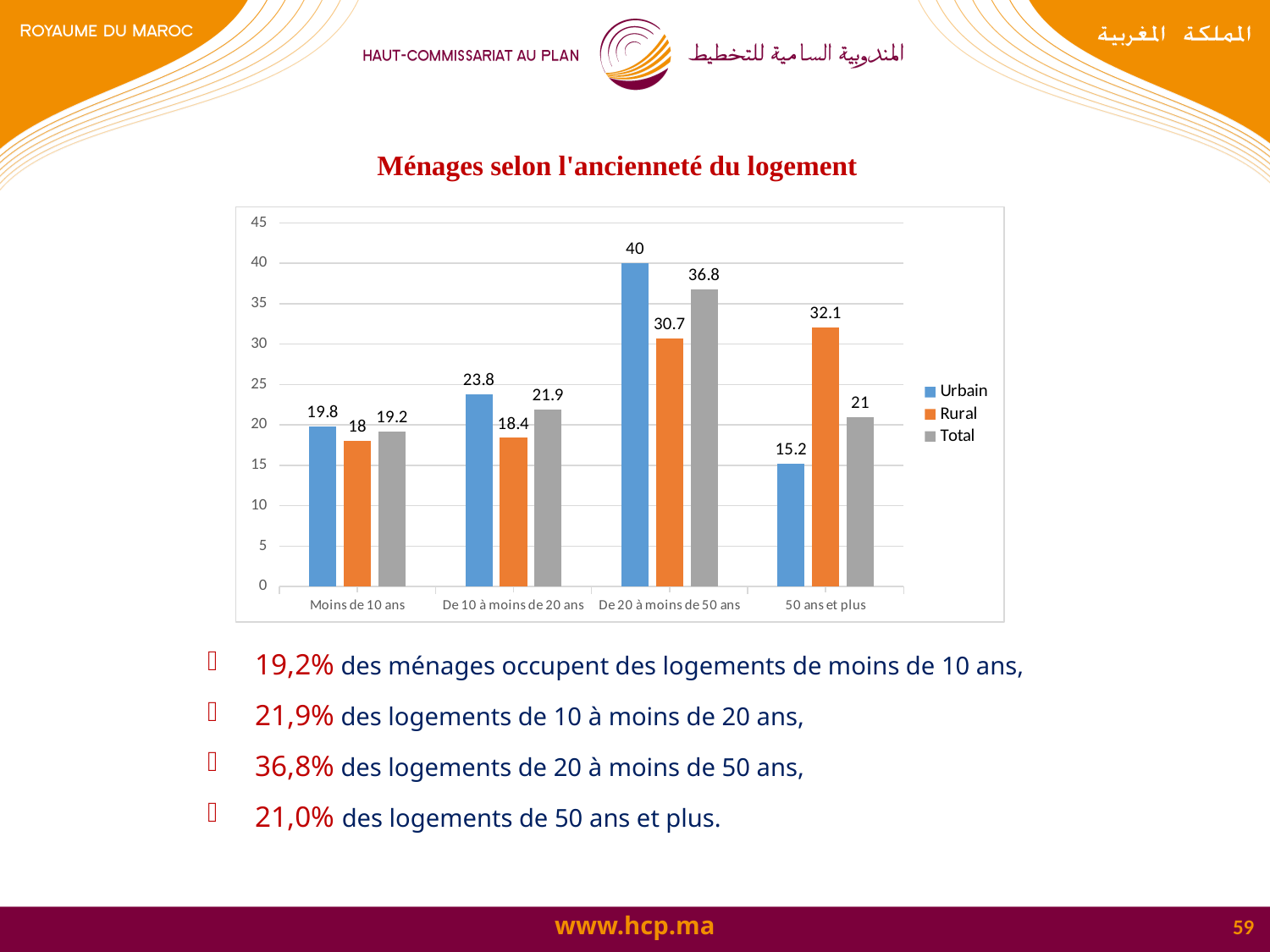
How many categories are shown on the x axis? 4 What is the difference between the Urban and Rural values for 'De 20 à moins de 50 ans'? 9.3 For '50 ans et plus', which is larger, the Urban value or the Rural value? Rural Which category has the highest Total value? De 20 à moins de 50 ans Which category has the lowest Urban value? 50 ans et plus Is the Total value for 'De 10 à moins de 20 ans' greater or less than 25? less What is the Total value for 'Moins de 10 ans'? 19.2 What is the Rural value for '50 ans et plus'? 32.1 How many series does the legend list? 3 What is the title of the chart? Ménages selon l'ancienneté du logement What is the Urban value for 'De 20 à moins de 50 ans'? 40 What kind of chart is shown on the slide? bar chart